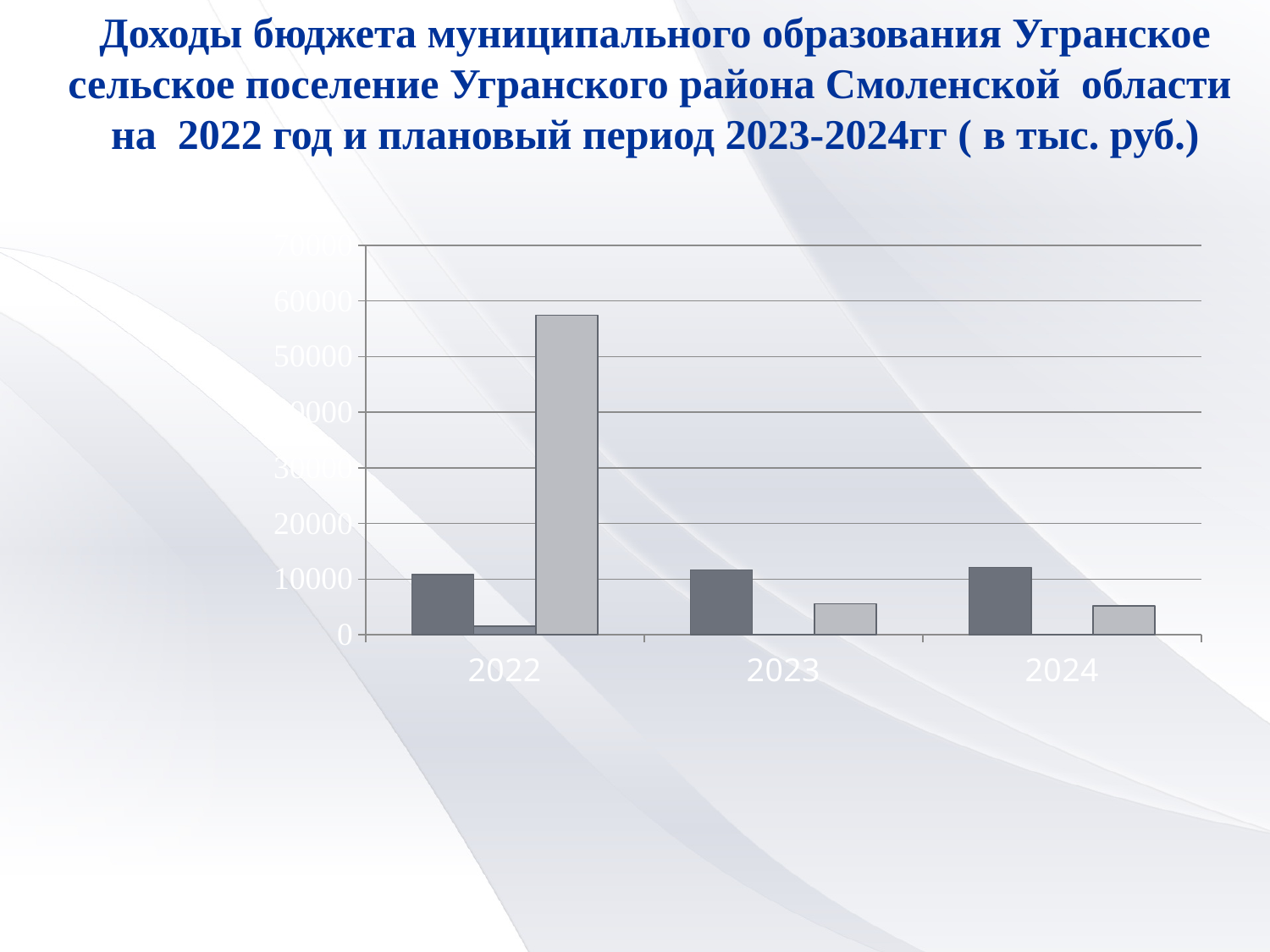
What is the highest value shown on the y axis of the chart? 70000 Is the value of the dark grey bar for 2022 greater or less than 20000? less How many years are shown on the x axis of the chart? 3 Which is larger for 2023: the dark grey bar or the light grey bar? the dark grey bar Which year has the tallest bar in the chart? 2022 Which is larger: the light grey bar for 2022 or the light grey bar for 2023? the light grey bar for 2022 Is the value of the dark grey bar for 2024 greater or less than 10000? greater What kind of chart is shown on the slide? bar chart Is the value of the tallest (light grey) bar for 2022 greater or less than 60000? less How many bars are plotted for each year in the chart? 3